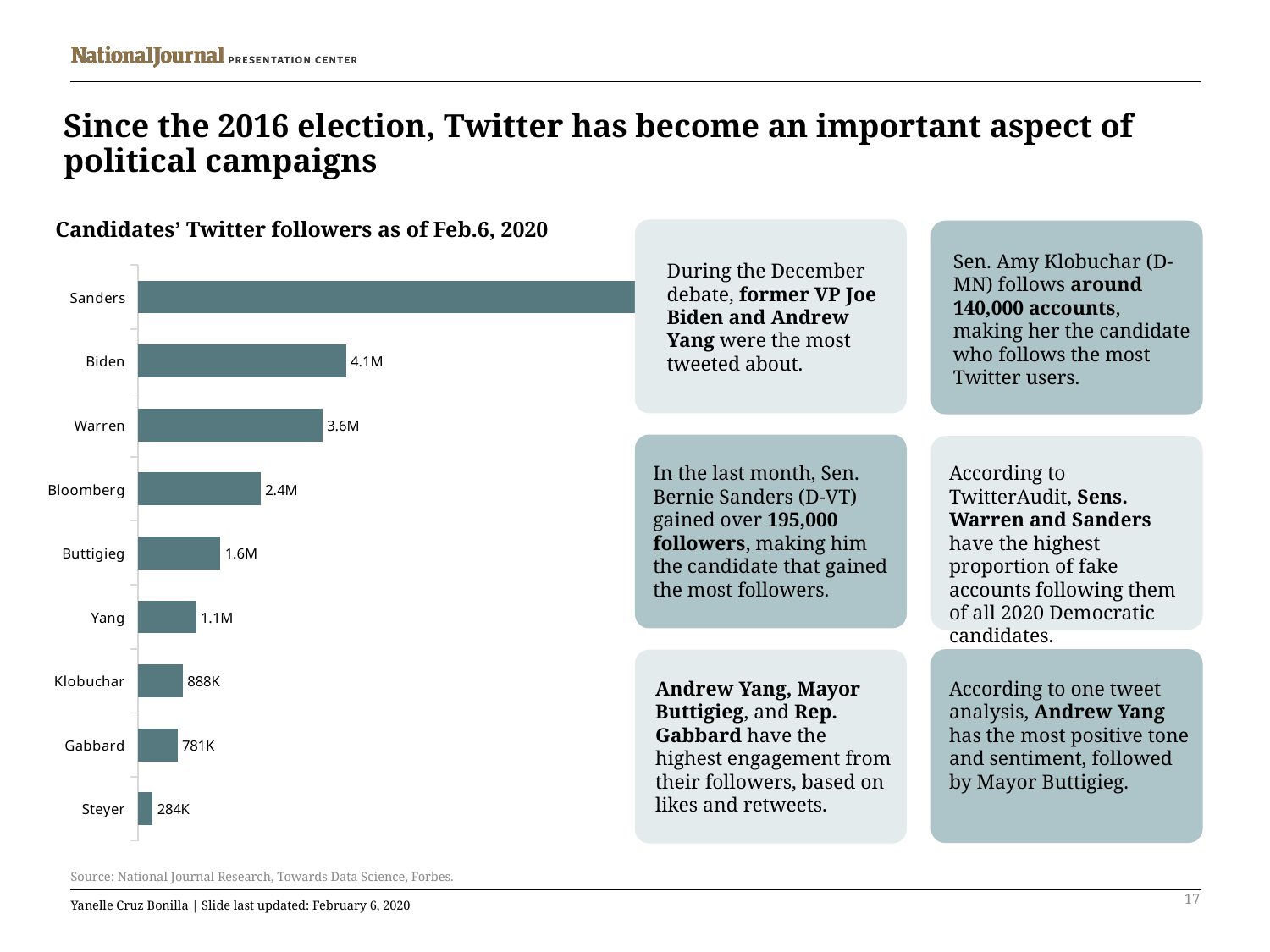
How many candidates are shown in the chart? 9 How many Twitter followers does Warren have according to the chart? 3.6M What is the value shown for Steyer? 284K What is the difference between Biden's and Warren's follower counts? 0.5M What is the title of the chart on the slide? Candidates' Twitter followers as of Feb.6, 2020 Which candidate has the fewest Twitter followers in the chart? Steyer Who has more Twitter followers, Bloomberg or Buttigieg? Bloomberg Which candidate has the most Twitter followers in the chart? Sanders What type of chart is used to show candidates' Twitter followers? Bar chart What is the value shown for Klobuchar? 888K What is the value for Biden in the Candidates' Twitter followers chart? 4.1M What is the difference between Klobuchar's and Gabbard's follower counts? 107K